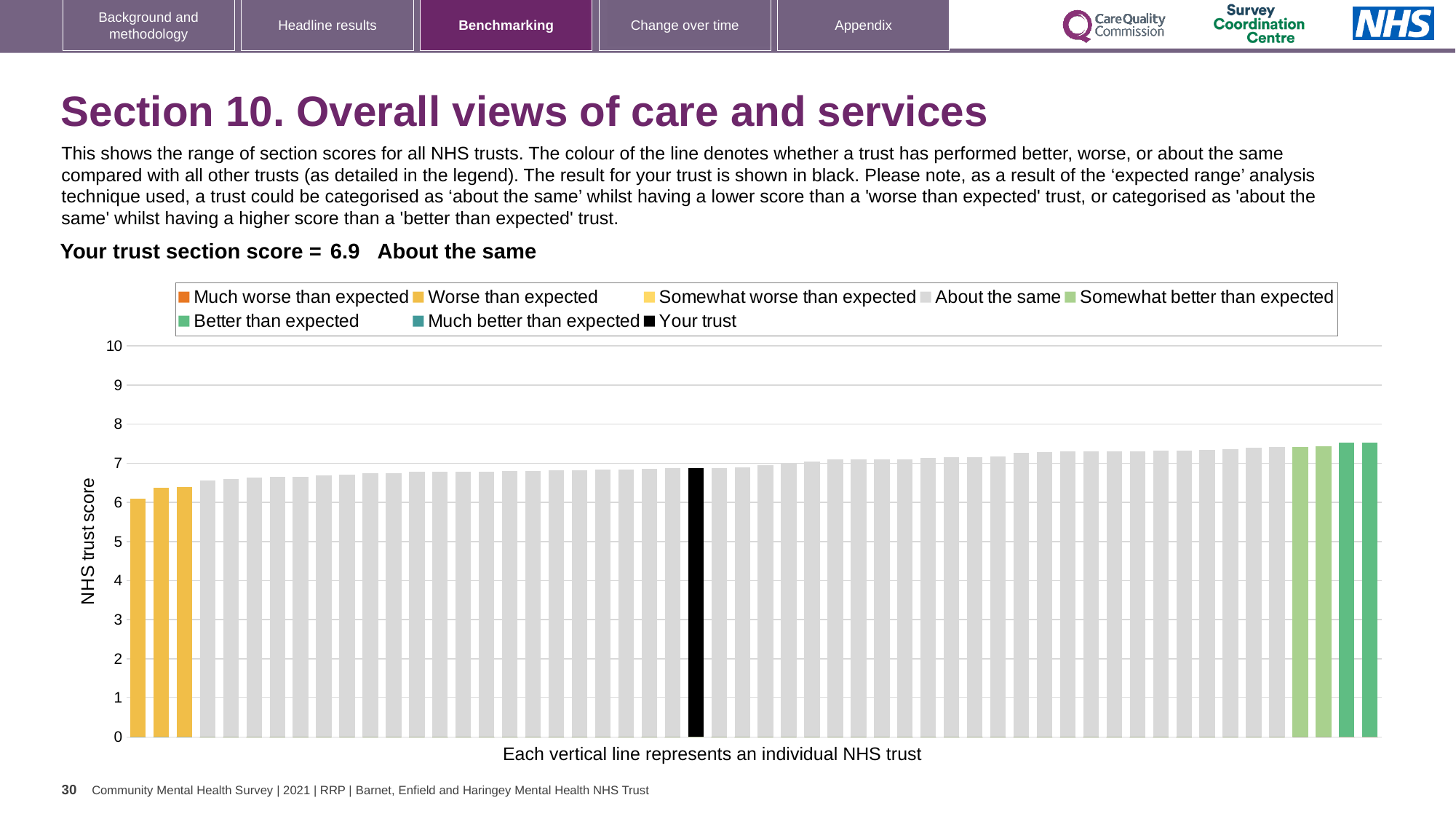
What colour is the bar representing your trust? black Do the bar values rise or fall from left to right along the x axis? rise Is the value of the lowest bar in the chart greater or less than 5? greater Is the value of the highest bar in the chart greater or less than 8? less How many bars are coloured as 'Worse than expected'? 3 What is the section score for your trust shown on the slide? 6.9 What is the label on the vertical axis of the chart? NHS trust score What kind of chart is shown on the slide? bar chart Is the value of the black 'Your trust' bar greater or less than 6? greater Which category is your trust placed in for this section? About the same How many entries does the chart legend list? 8